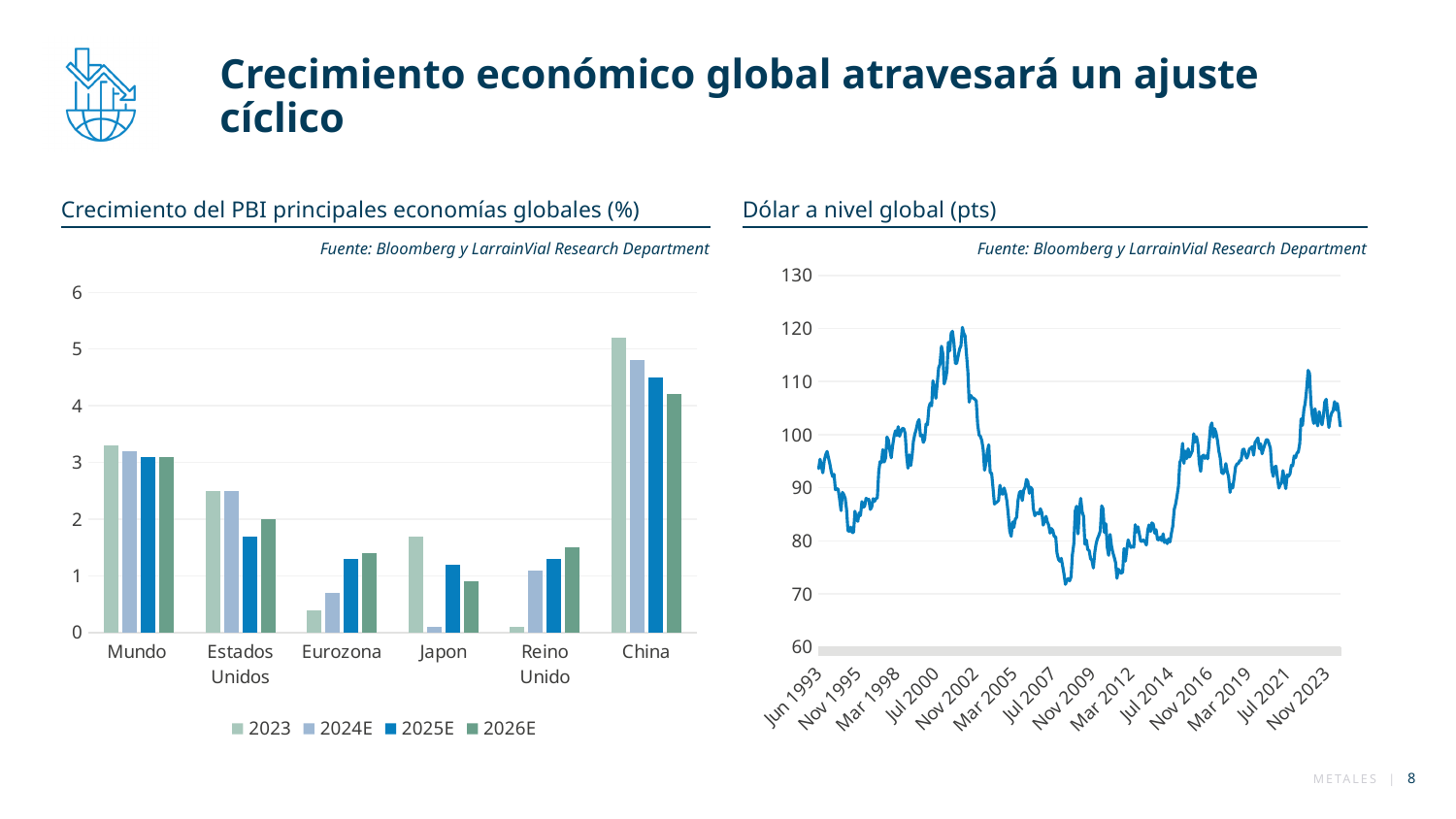
What kind of chart is "Dólar a nivel global (pts)"? line chart In the chart "Crecimiento del PBI principales economías globales (%)", how many series does the legend list? 4 In the chart "Crecimiento del PBI principales economías globales (%)", how many economies are shown on the x axis? 6 In the chart "Crecimiento del PBI principales economías globales (%)", is the 2023 value for Eurozona greater or less than 1? less What source is cited for the chart "Dólar a nivel global (pts)"? Bloomberg y LarrainVial Research Department In the chart "Crecimiento del PBI principales economías globales (%)", which economy has the lowest 2024E value? Japon In the chart "Crecimiento del PBI principales economías globales (%)", do the Eurozona bars rise or fall from 2023 to 2026E? rise In the chart "Crecimiento del PBI principales economías globales (%)", which is larger for 2023: Mundo or Estados Unidos? Mundo In the chart "Crecimiento del PBI principales economías globales (%)", is the 2023 value for Mundo greater or less than 3? greater In the chart "Crecimiento del PBI principales economías globales (%)", which economy has the highest 2023 value? China In the chart "Dólar a nivel global (pts)", is the peak value reached around 2001-2002 greater or less than 110? greater What kind of chart is "Crecimiento del PBI principales economías globales (%)"? bar chart